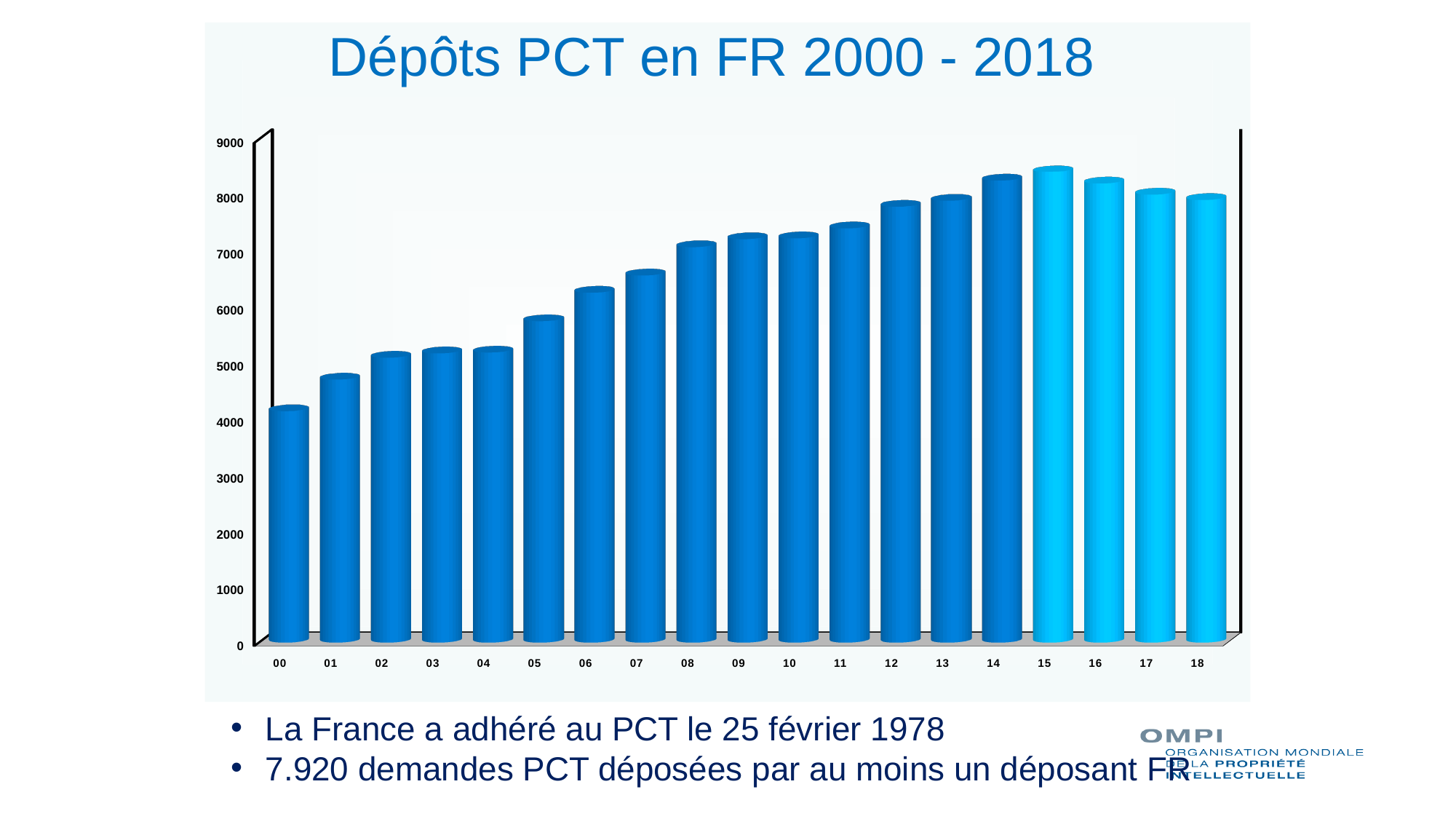
Which year has the lowest bar in the chart? 00 Is the value for 14 greater or less than 8000? greater How many bars (years) are plotted in the chart? 19 Which year has the larger value, 07 or 03? 07 Do the values generally rise or fall from 00 to 15? rise Is the value for 01 greater or less than 5000? less Is the value for 00 greater or less than 4000? greater What kind of chart is shown on the slide? bar chart Which year has the highest bar in the chart? 15 What is the title of the chart? Dépôts PCT en FR 2000 - 2018